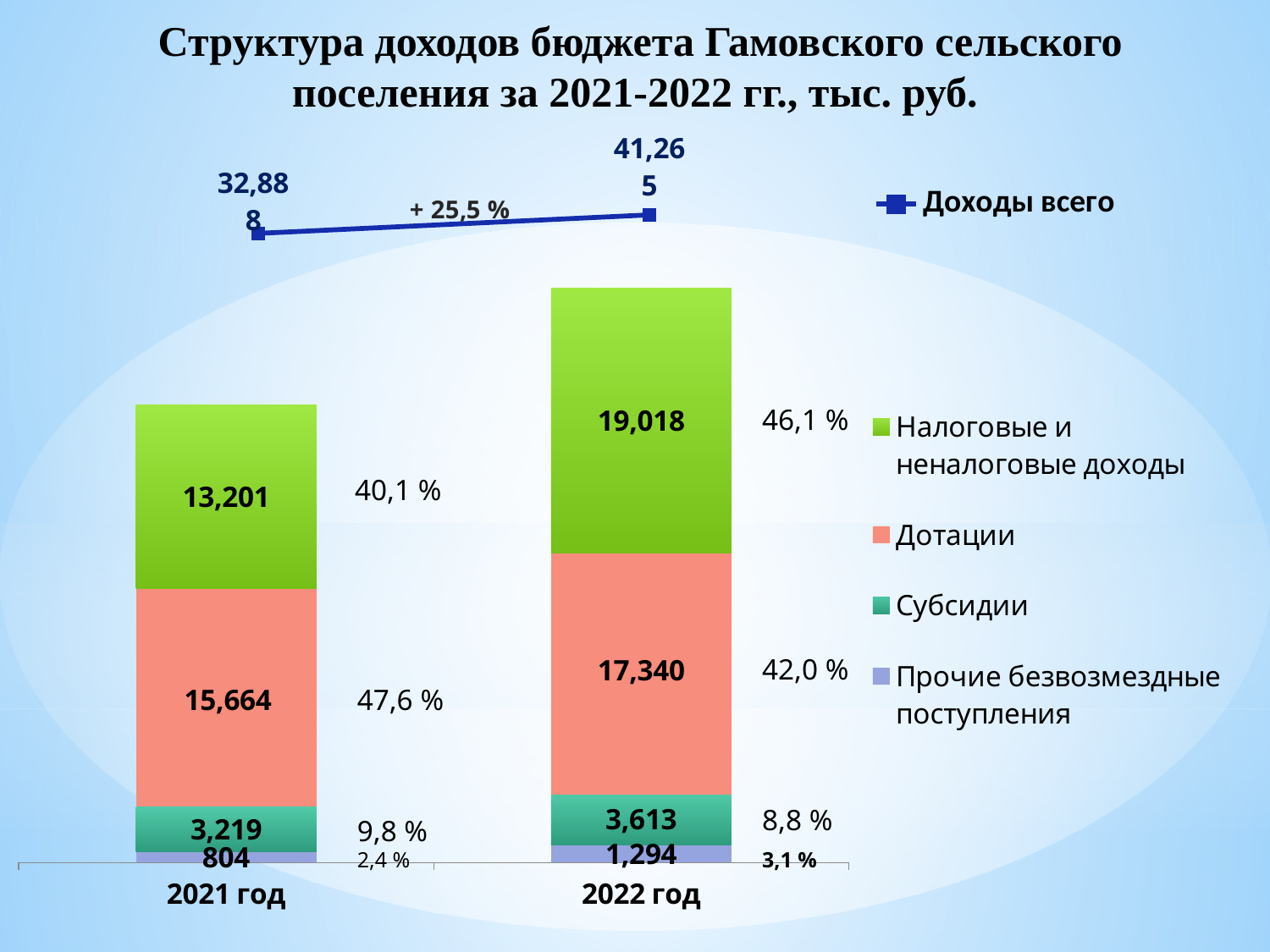
Which segment is the smallest in the 2021 год bar? Прочие безвозмездные поступления What is the value of Налоговые и неналоговые доходы for 2021 год? 13,201 What is the difference between Налоговые и неналоговые доходы in 2022 год and in 2021 год? 5,817 What type of chart is used to show the income structure? Stacked bar chart What is the value of Субсидии for 2022 год? 3,613 What is the value of Прочие безвозмездные поступления for 2021 год? 804 What is the value of Дотации for 2022 год? 17,340 What is the total Доходы всего value shown for 2022 год? 41,265 What percentage share is shown for Дотации in 2021 год? 47,6 % How many year categories are shown on the x axis? 2 What percentage change in total income is shown between 2021 год and 2022 год? + 25,5 % Which is larger in 2022 год: Налоговые и неналоговые доходы or Дотации? Налоговые и неналоговые доходы